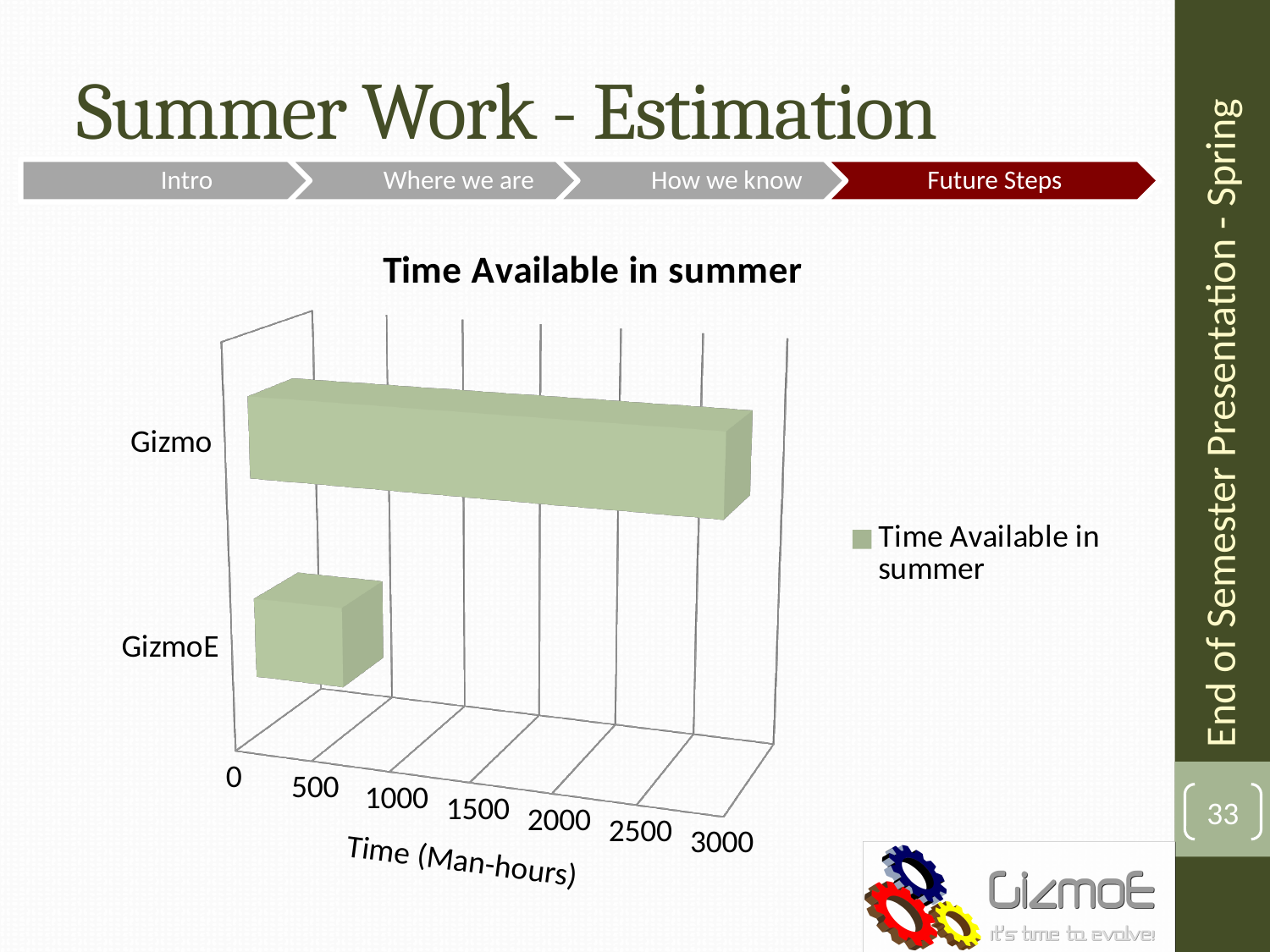
What is the label of the value axis in the chart? Time (Man-hours) How many series does the legend list? 1 Which has more time available in summer, Gizmo or GizmoE? Gizmo What is the title of the chart? Time Available in summer Is the value for Gizmo greater or less than 2500? greater Which category has the lowest time available in summer? GizmoE Is the value for GizmoE greater or less than 1000? less How many categories are plotted in the chart? 2 What kind of chart is shown on the slide? bar chart Which category has the highest time available in summer? Gizmo Is the value for GizmoE greater or less than 2000? less